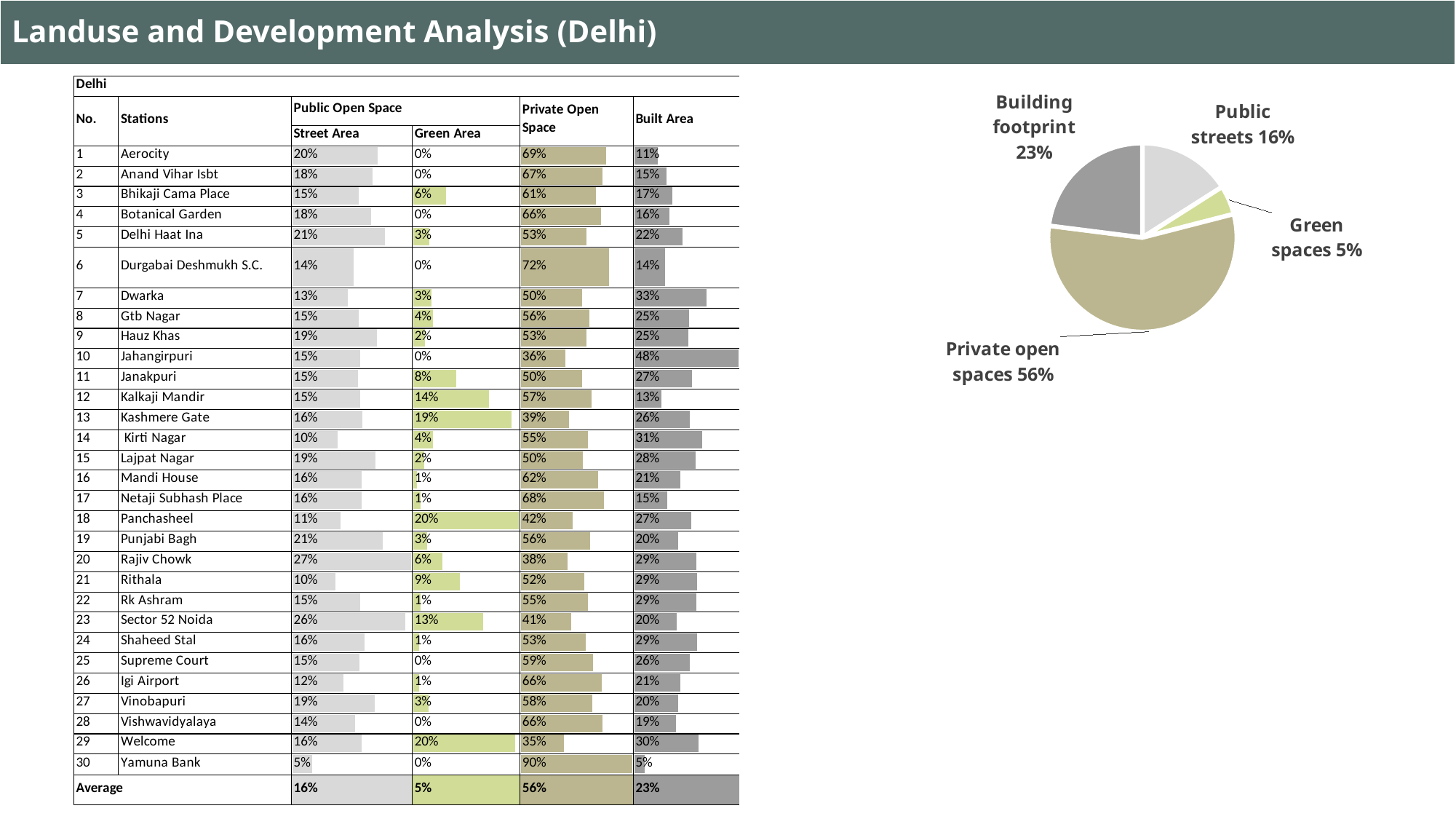
What type of chart is shown on the right side of the slide? Pie chart In the pie chart, how much larger is the Private open spaces share than the Building footprint share? 33 percentage points In the pie chart, what share do Green spaces have? 5% In the pie chart, is the Private open spaces share greater or less than 50%? greater Which slice of the pie chart is the smallest? Green spaces In the pie chart, which is larger: Building footprint or Public streets? Building footprint Which slice of the pie chart is the largest? Private open spaces In the pie chart, what percentage is labelled for Building footprint? 23% In the pie chart, what percentage is shown for Public streets? 16% In the pie chart, what share is shown for Private open spaces? 56% In the pie chart, what is the difference between the Public streets share and the Green spaces share? 11 percentage points How many slices does the pie chart have? 4